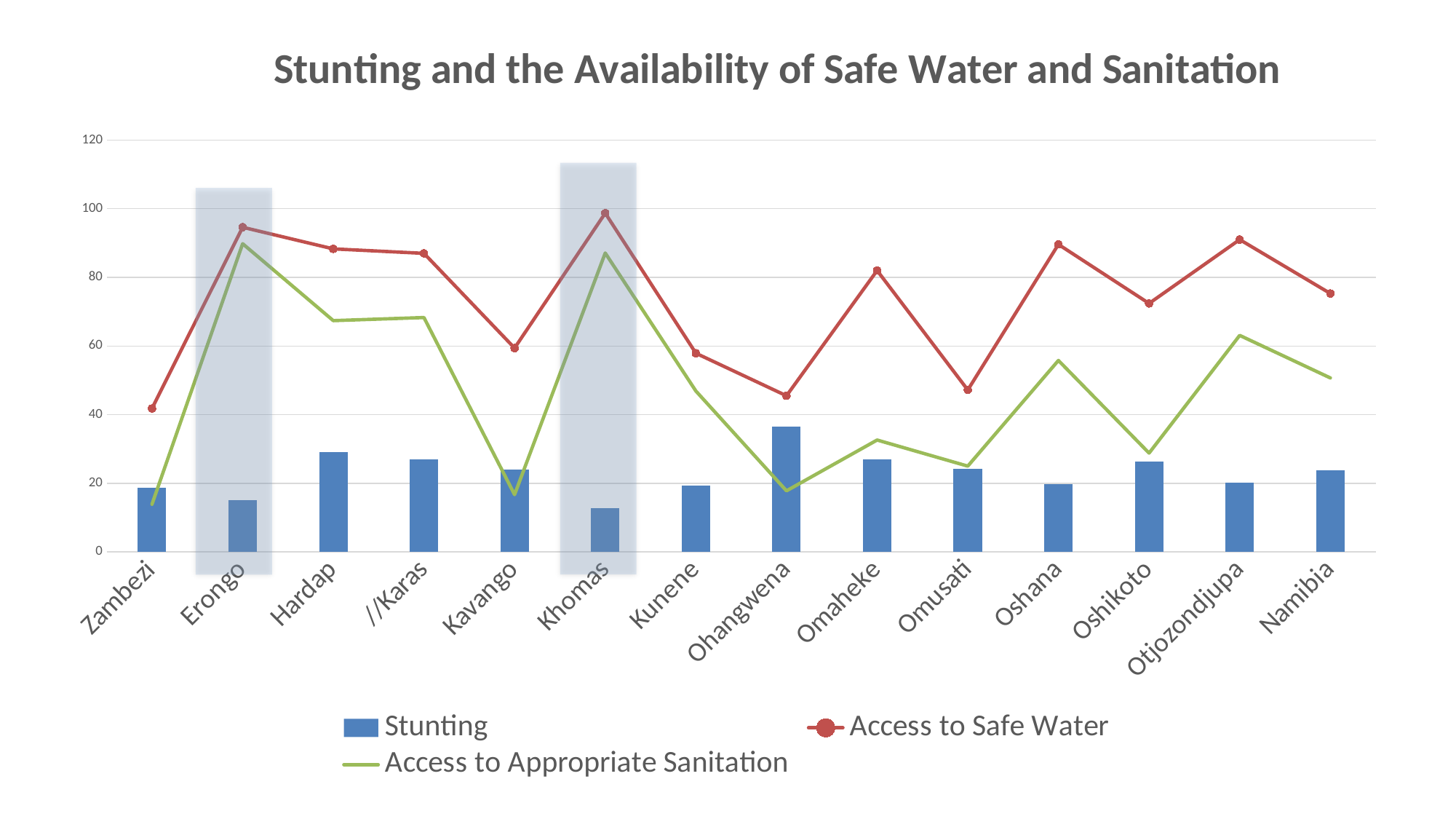
Is the Access to Safe Water value for Khomas greater or less than 80? greater Which has the larger Stunting value, Hardap or Erongo? Hardap What is the title of the chart? Stunting and the Availability of Safe Water and Sanitation Which category has the highest Access to Safe Water value? Khomas Is the Stunting value for Ohangwena greater or less than 20? greater Is the Access to Appropriate Sanitation value for Kavango greater or less than 20? less How many categories are shown on the x axis? 14 How many series does the legend list? 3 Which category has the highest Stunting value? Ohangwena Which two categories are highlighted with shaded columns? Erongo and Khomas What kind of chart is this? Combined bar and line chart